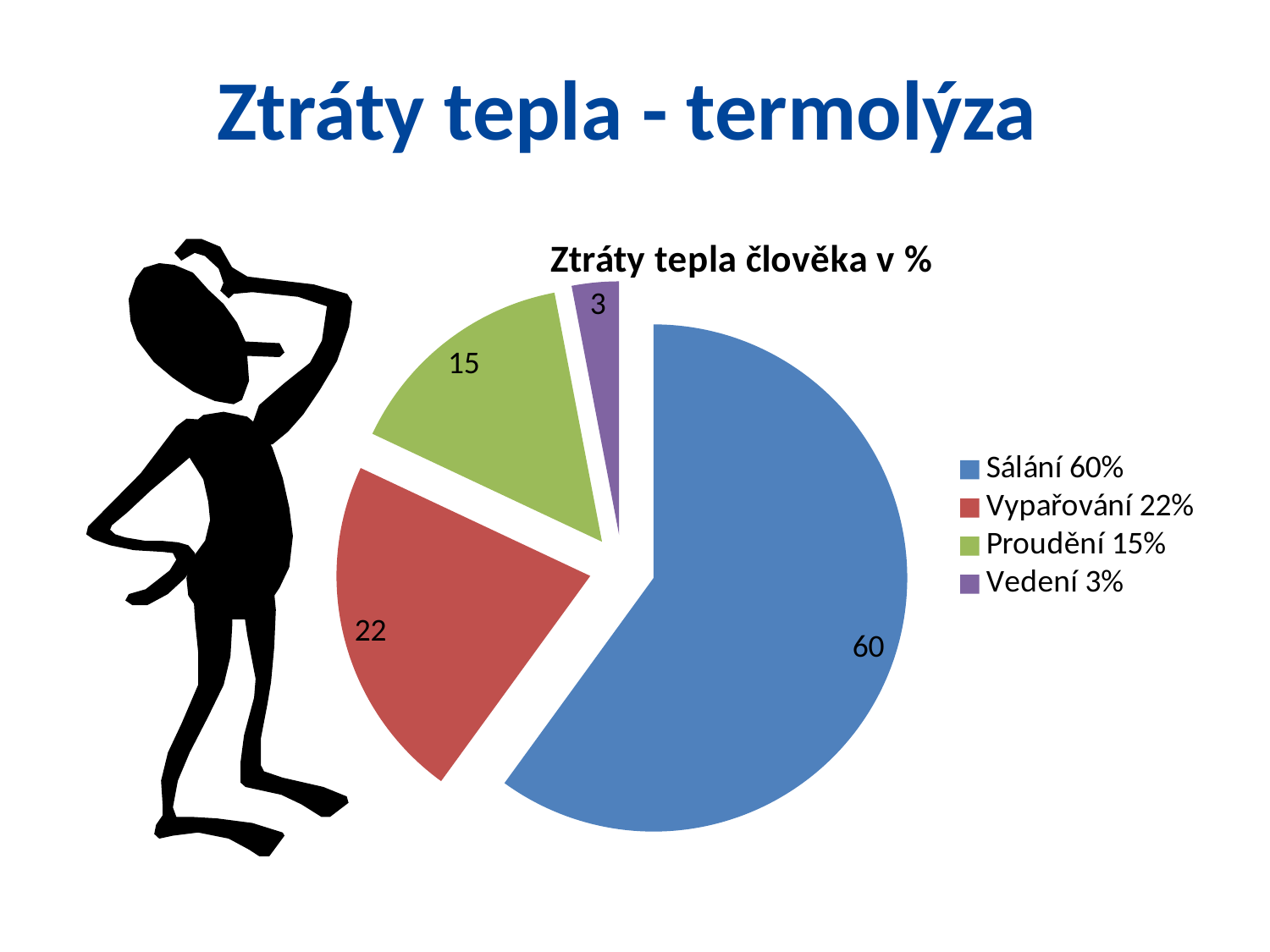
What is the value for Vypařování? 22 How many slices does the pie chart have? 4 Which is larger, Proudění or Vedení? Proudění What colour is the slice for Proudění? green Which category has the smallest slice? Vedení What is the difference between the values for Sálání and Vypařování? 38 What kind of chart is shown on the slide? pie chart What is the value for Proudění? 15 What is the value for Sálání? 60 What is the value for Vedení? 3 Which category has the largest slice? Sálání What is the title of the chart? Ztráty tepla člověka v %